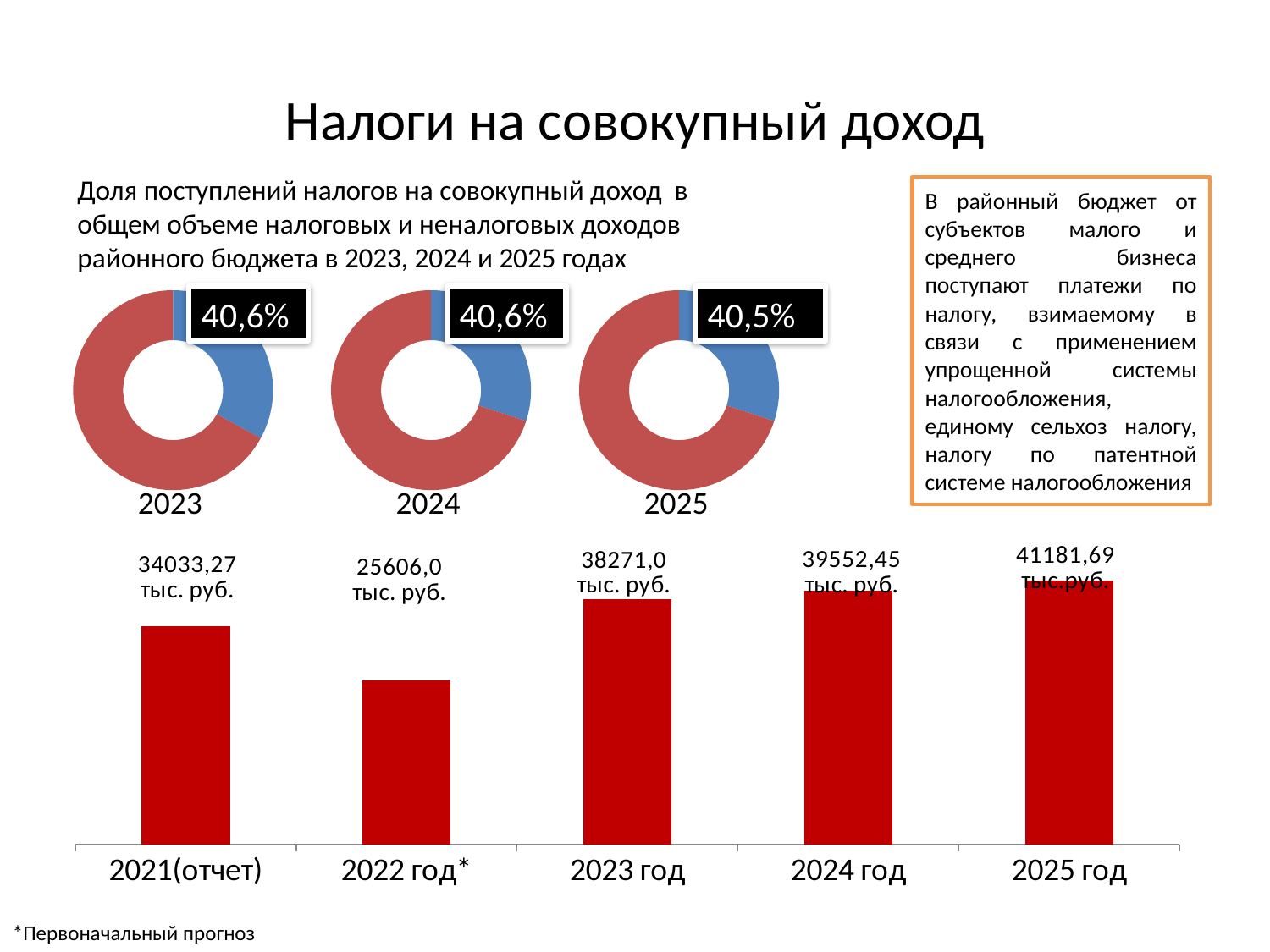
In the bar chart at the bottom of the slide, which is larger: the value for 2021(отчет) or the value for 2023 год? 2023 год In the bar chart at the bottom of the slide, which year has the highest value? 2025 год In the bar chart at the bottom of the slide, what is the value for 2021(отчет)? 34033,27 тыс. руб. In the bar chart at the bottom of the slide, which year has the lowest value? 2022 год* In the bar chart at the bottom of the slide, what is the difference between the values for 2025 год and 2024 год? 1629,24 тыс. руб. In the bar chart at the bottom of the slide, what is the value for 2022 год*? 25606,0 тыс. руб. What kind of chart is shown at the bottom of the slide? Bar chart In the donut chart labelled 2025, what share is shown in the data label? 40,5% In the bar chart at the bottom of the slide, what is the value for 2024 год? 39552,45 тыс. руб. In the donut chart labelled 2023, what share is shown in the data label? 40,6% In the bar chart at the bottom of the slide, do the values rise or fall from 2022 год* to 2025 год? Rise How many bars are in the bar chart at the bottom of the slide? 5